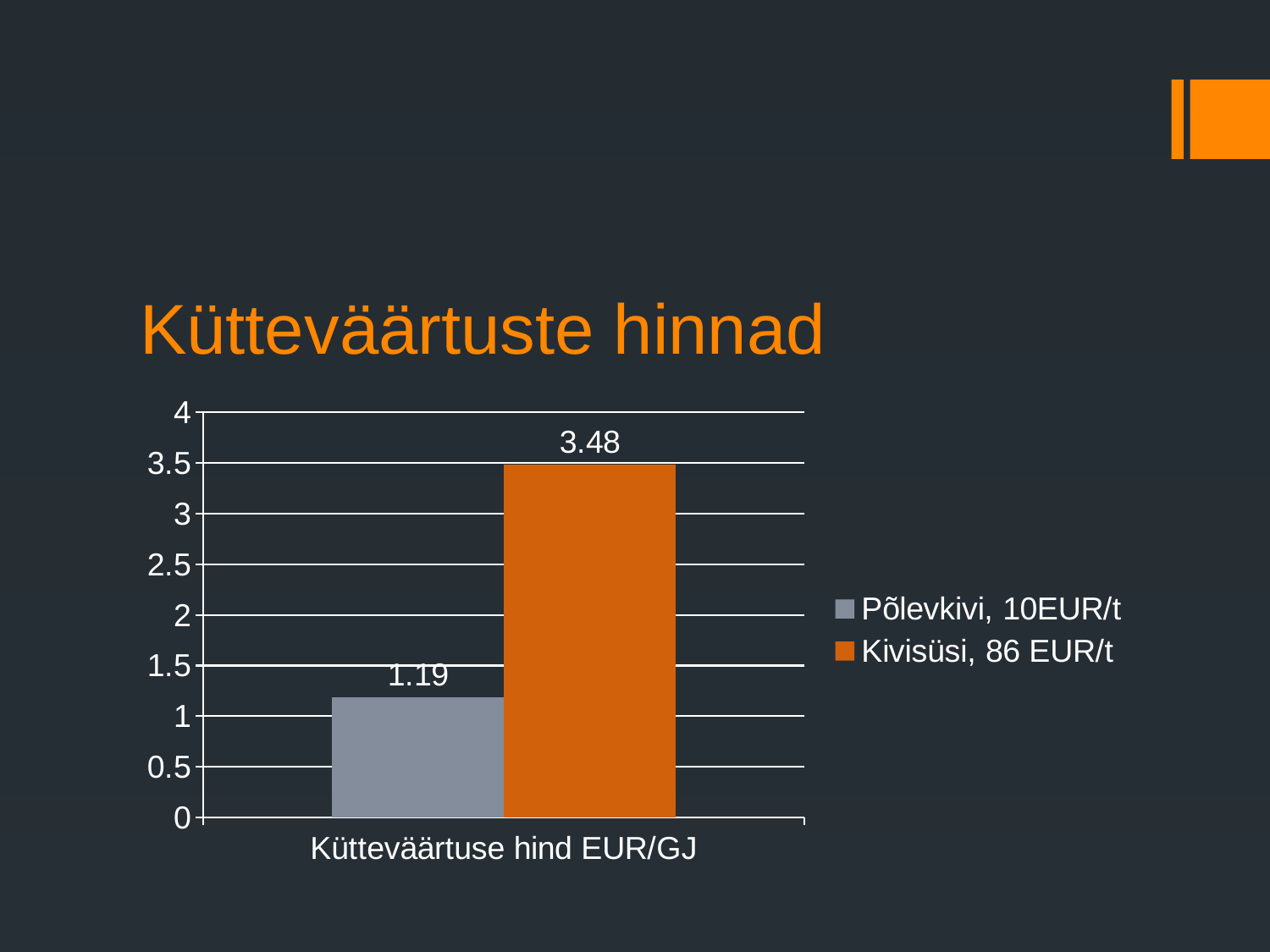
What colour is the bar for Kivisüsi, 86 EUR/t? orange What is the category label on the x axis? Kütteväärtuse hind EUR/GJ Which series has the higher value? Kivisüsi, 86 EUR/t What is the value for Põlevkivi, 10EUR/t? 1.19 What is the difference between the values for Kivisüsi, 86 EUR/t and Põlevkivi, 10EUR/t? 2.29 Is the value for Põlevkivi, 10EUR/t greater or less than 1.5? less What is the value for Kivisüsi, 86 EUR/t? 3.48 How many series does the legend list? 2 Which series has the lower value? Põlevkivi, 10EUR/t Is the value for Kivisüsi, 86 EUR/t larger or smaller than the value for Põlevkivi, 10EUR/t? larger What kind of chart is shown on the slide? bar chart Is the value for Kivisüsi, 86 EUR/t greater or less than 3? greater